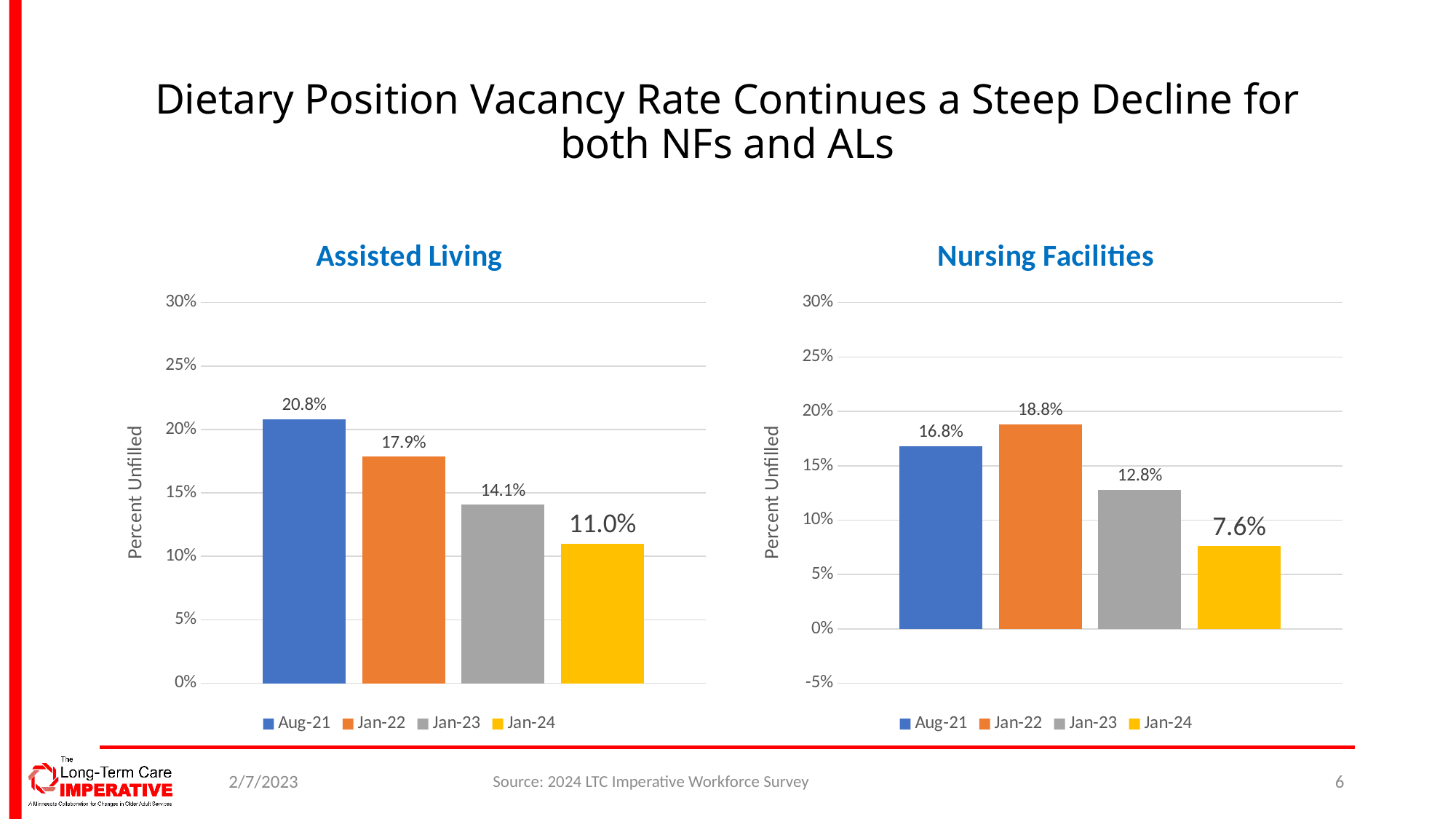
In the Assisted Living chart, which period has the lowest value? Jan-24 In the Nursing Facilities chart, which period has the highest value? Jan-22 What kind of chart is the Nursing Facilities chart? Bar chart In the Nursing Facilities chart, do the values rise or fall from Jan-22 to Jan-24? Fall In the Nursing Facilities chart, is the value for Jan-24 greater or less than 10%? less In the Nursing Facilities chart, what is the difference between the Aug-21 and Jan-24 values? 9.2% Which is larger: the Jan-23 value in the Assisted Living chart or the Jan-23 value in the Nursing Facilities chart? Assisted Living In the Assisted Living chart, what is the difference between the Jan-22 and Jan-23 values? 3.8% In the Nursing Facilities chart, what is the value for Jan-22? 18.8% How many series does the legend of the Assisted Living chart list? 4 In the Assisted Living chart, what is the value for Jan-24? 11.0% In the Assisted Living chart, what is the value for Aug-21? 20.8%